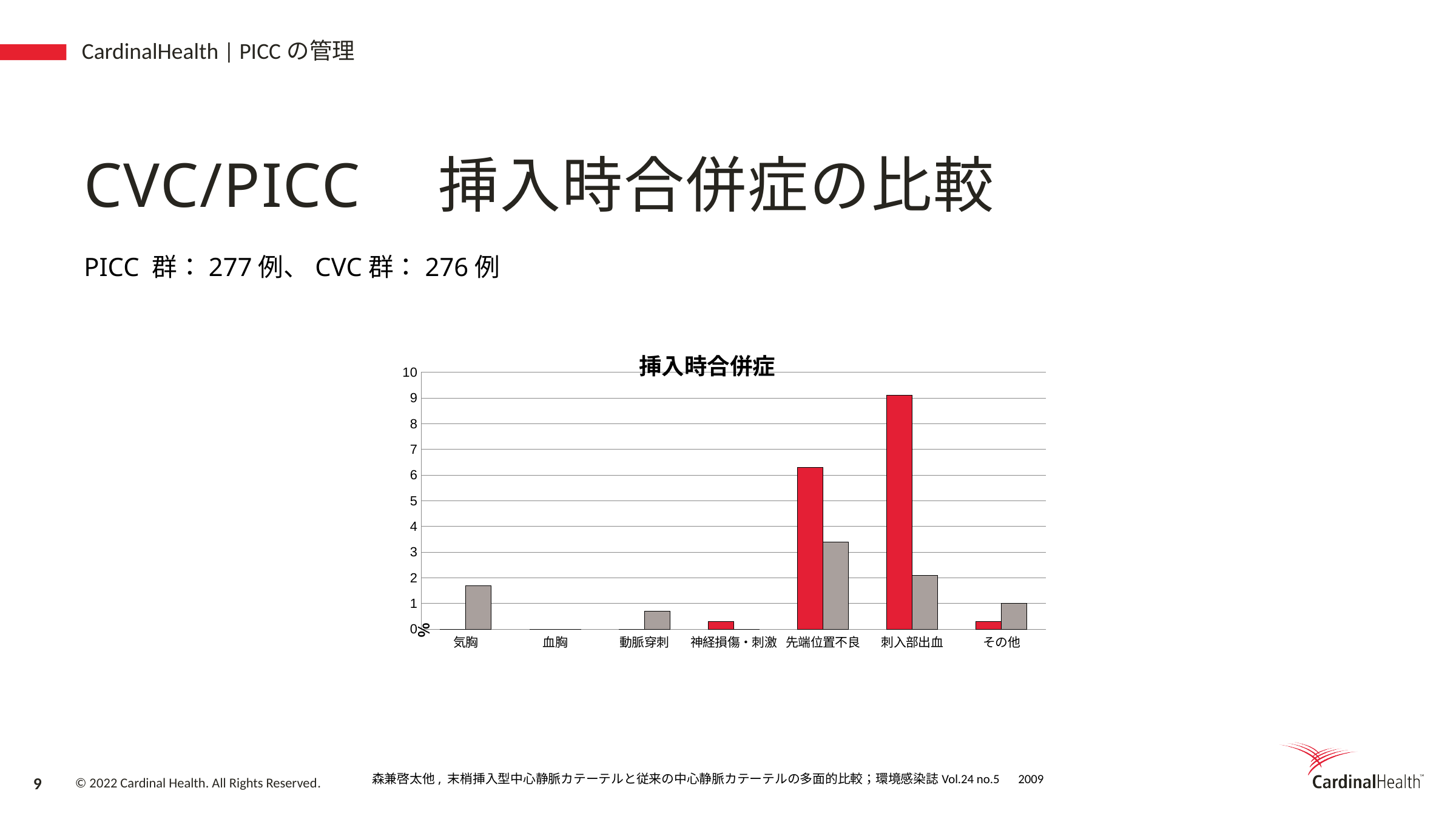
What is the title of the chart? 挿入時合併症 Is the gray bar for 気胸 greater or less than 2? less For 刺入部出血, which bar is taller, the red bar or the gray bar? the red bar What is the maximum value shown on the y axis of the chart? 10 Which category has the tallest gray bar? 先端位置不良 What kind of chart is shown on the slide? bar chart For 気胸, which bar is taller, the red bar or the gray bar? the gray bar How many categories are shown on the x axis of the chart? 7 Which category has the tallest red bar? 刺入部出血 Is the red bar for 先端位置不良 greater or less than 6? greater Is the gray bar for 先端位置不良 greater or less than 3? greater